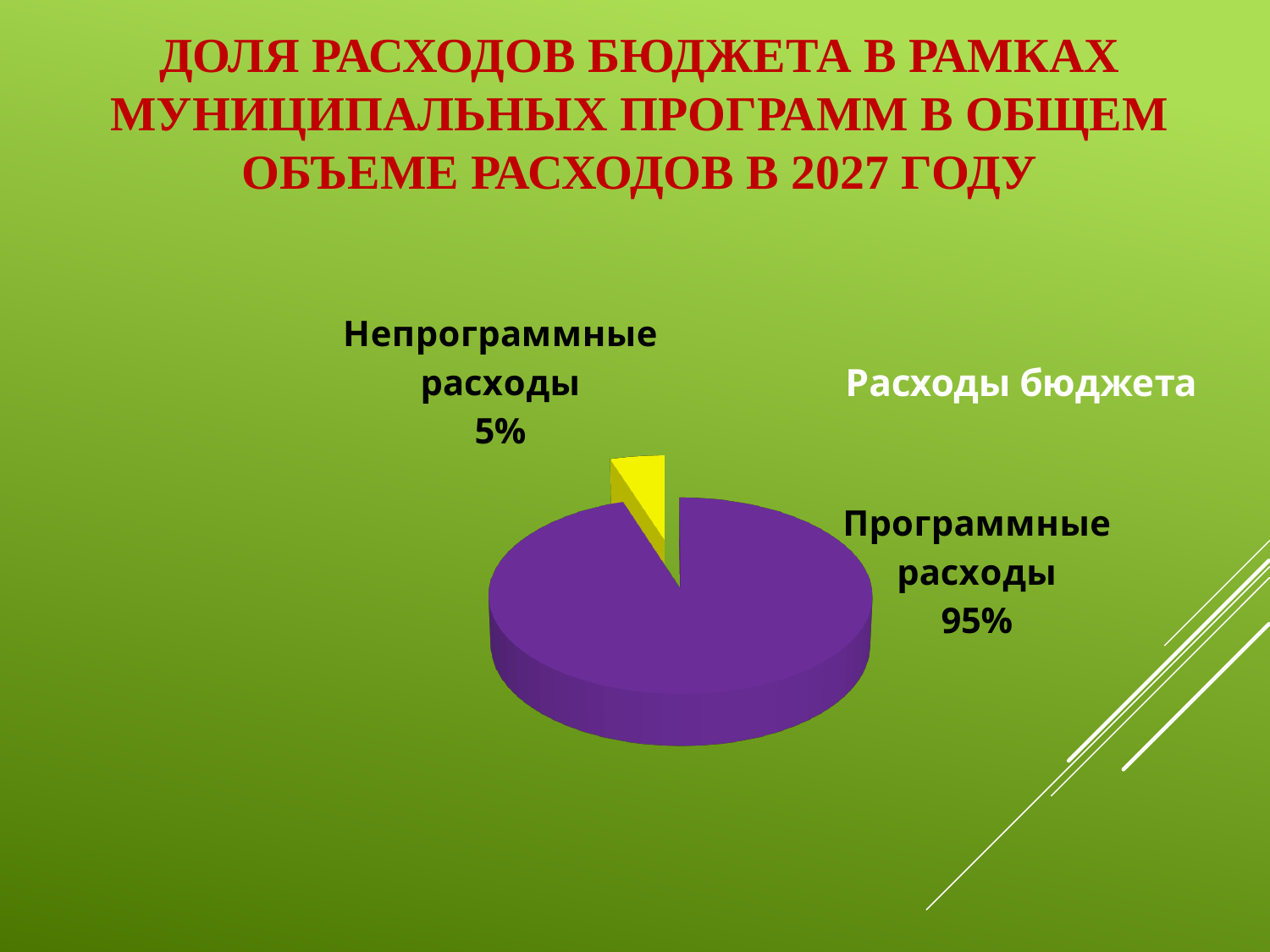
What kind of chart is shown on the slide? Pie chart Which slice of the pie is the smallest? Непрограммные расходы How many slices does the pie chart have? 2 What share of the pie is labelled "Программные расходы"? 95% What is the title of the chart? Расходы бюджета Which slice of the pie is the largest? Программные расходы What share of the pie is labelled "Непрограммные расходы"? 5% What is the difference in percentage points between the "Программные расходы" and "Непрограммные расходы" slices? 90 What colour is the "Непрограммные расходы" slice? Yellow Which is larger: the "Программные расходы" slice or the "Непрограммные расходы" slice? Программные расходы